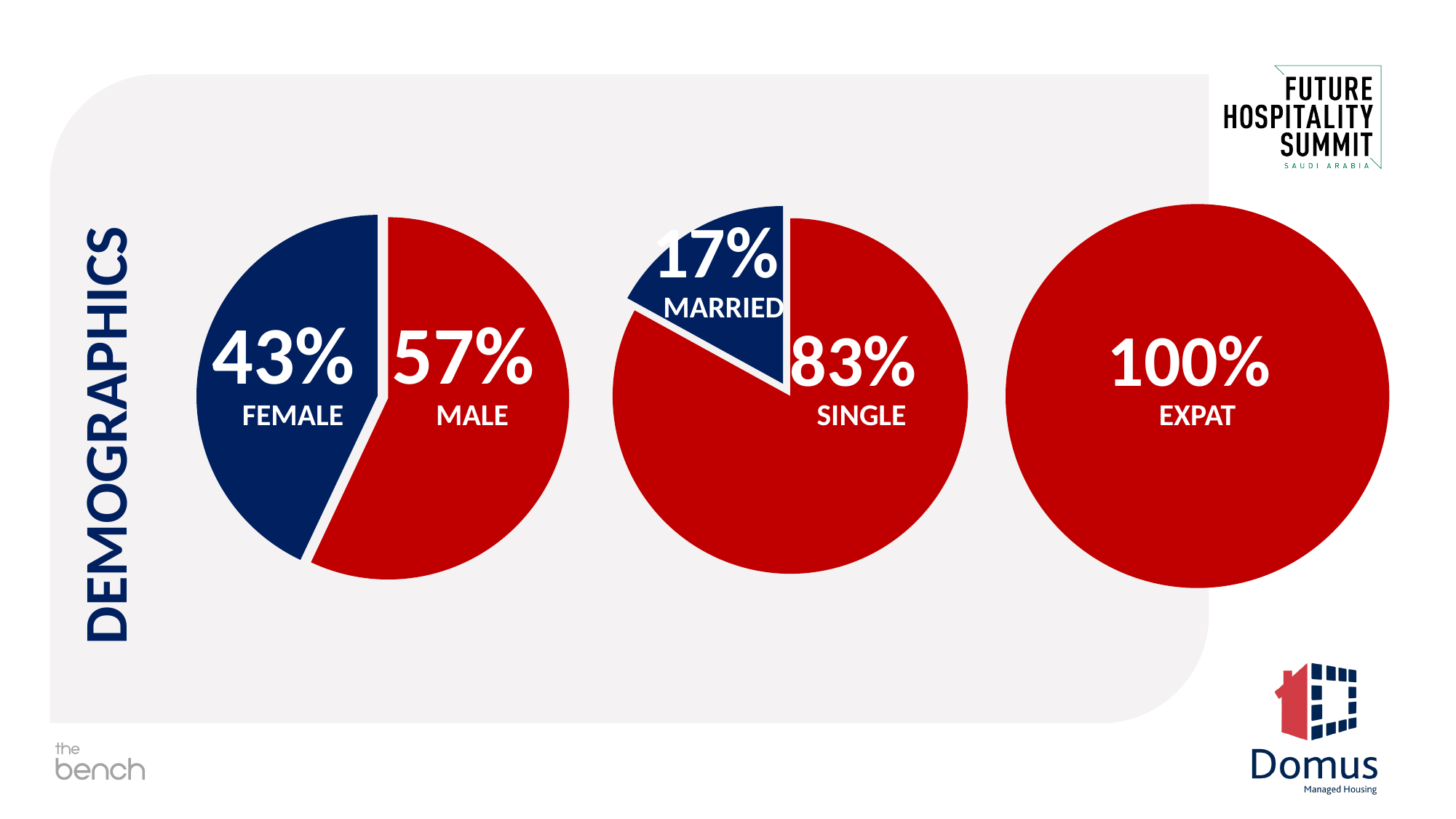
What kind of chart is used on this slide? Pie chart In the left pie chart, what share is labelled FEMALE? 43% In the middle pie chart, what share is labelled SINGLE? 83% In the middle pie chart, what is the difference between the SINGLE and MARRIED shares? 66% How many slices does the middle pie chart have? 2 In the middle pie chart, which slice is the smallest? MARRIED In the left pie chart, what is the difference between the MALE and FEMALE shares? 14% What is the title of the slide shown along the left side? DEMOGRAPHICS In the left pie chart, what share is labelled MALE? 57% In the middle pie chart, what share is labelled MARRIED? 17% In the right pie chart, what share is labelled EXPAT? 100% In the left pie chart, which slice is larger, FEMALE or MALE? MALE